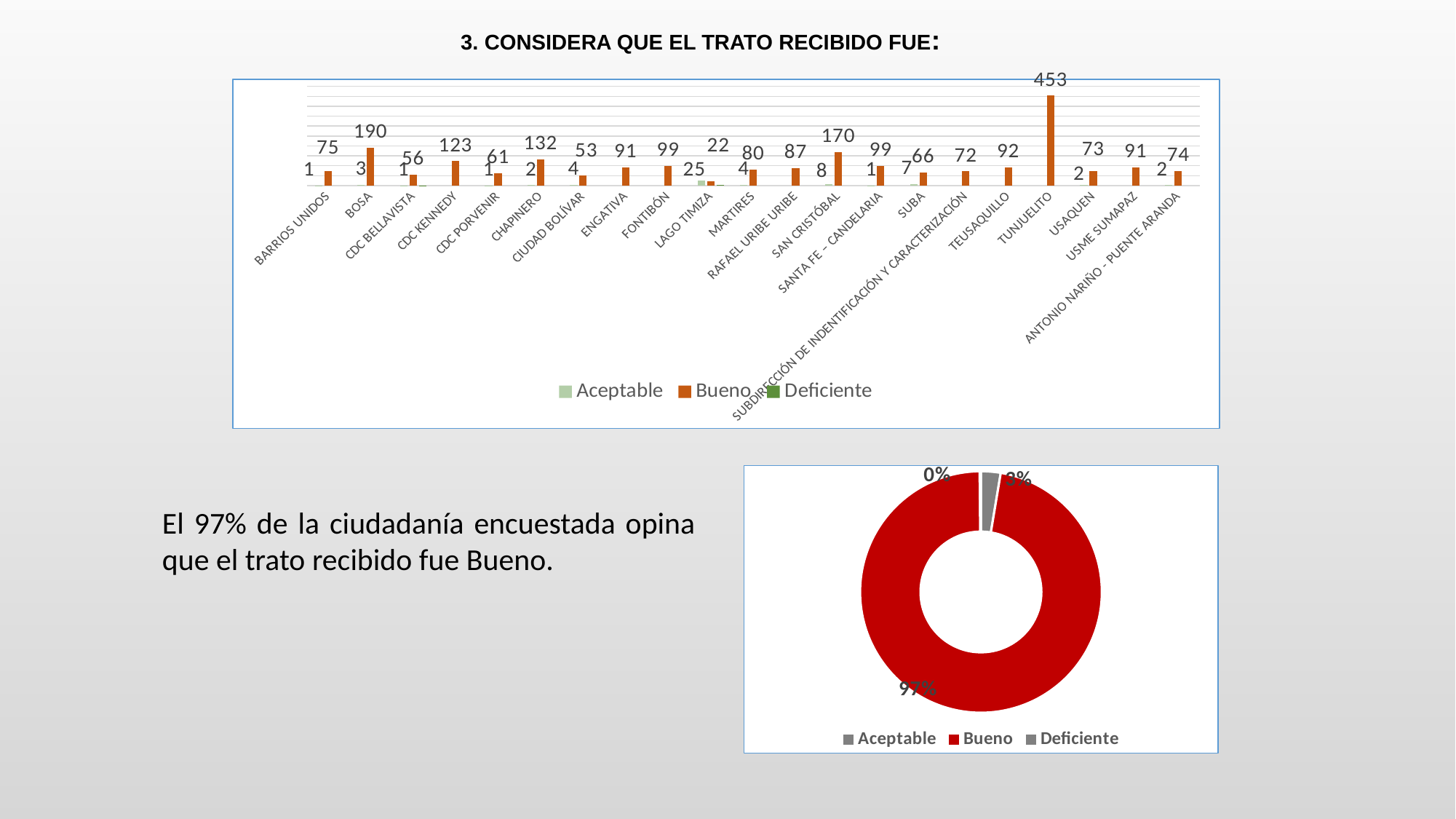
In the bar chart, how many categories are shown on the x axis? 21 In the bar chart, how many series does the legend list? 3 In the bar chart, which has a larger Bueno value, CDC KENNEDY or CHAPINERO? CHAPINERO In the bar chart, what is the Bueno value for TUNJUELITO? 453 In the doughnut chart, what colour represents Bueno? Red In the doughnut chart, what share does Bueno have? 97% In the bar chart, which category has the highest Bueno value? TUNJUELITO In the bar chart, what is the Bueno value for SAN CRISTÓBAL? 170 In the bar chart, which category has the lowest Bueno value? LAGO TIMIZA What kind of chart is the top chart on the slide? Bar chart In the bar chart, what is the difference between the Bueno values for TUNJUELITO and BOSA? 263 In the bar chart, what is the Bueno value for BOSA? 190